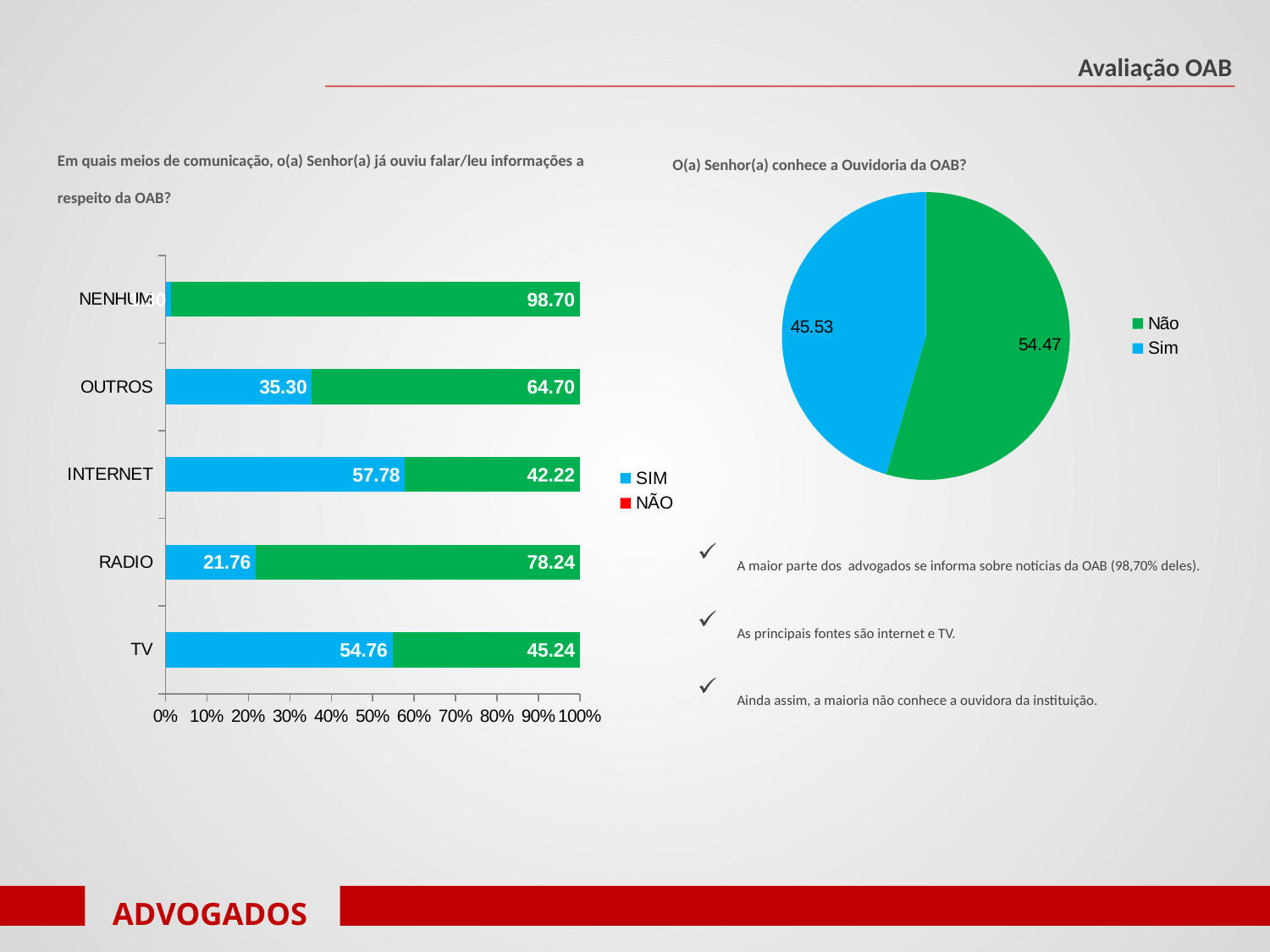
In the bar chart on the left, which has the larger SIM value, OUTROS or TV? TV What kind of chart is the chart on the left of the slide? bar chart In the bar chart on the left, what is the NÃO value for RADIO? 78.24 In the bar chart on the left, what is the SIM value for INTERNET? 57.78 In the bar chart on the left, what is the difference between the SIM values for TV and RADIO? 33.00 In the pie chart on the right, which slice is larger, Não or Sim? Não In the pie chart on the right, what is the value for Não? 54.47 In the bar chart on the left, which category has the highest SIM value? INTERNET In the bar chart on the left, which category has the lowest NÃO value? INTERNET How many categories are shown in the bar chart on the left? 5 In the bar chart on the left, what is the NÃO value for NENHUM? 98.70 How many series does the legend of the bar chart on the left list? 2